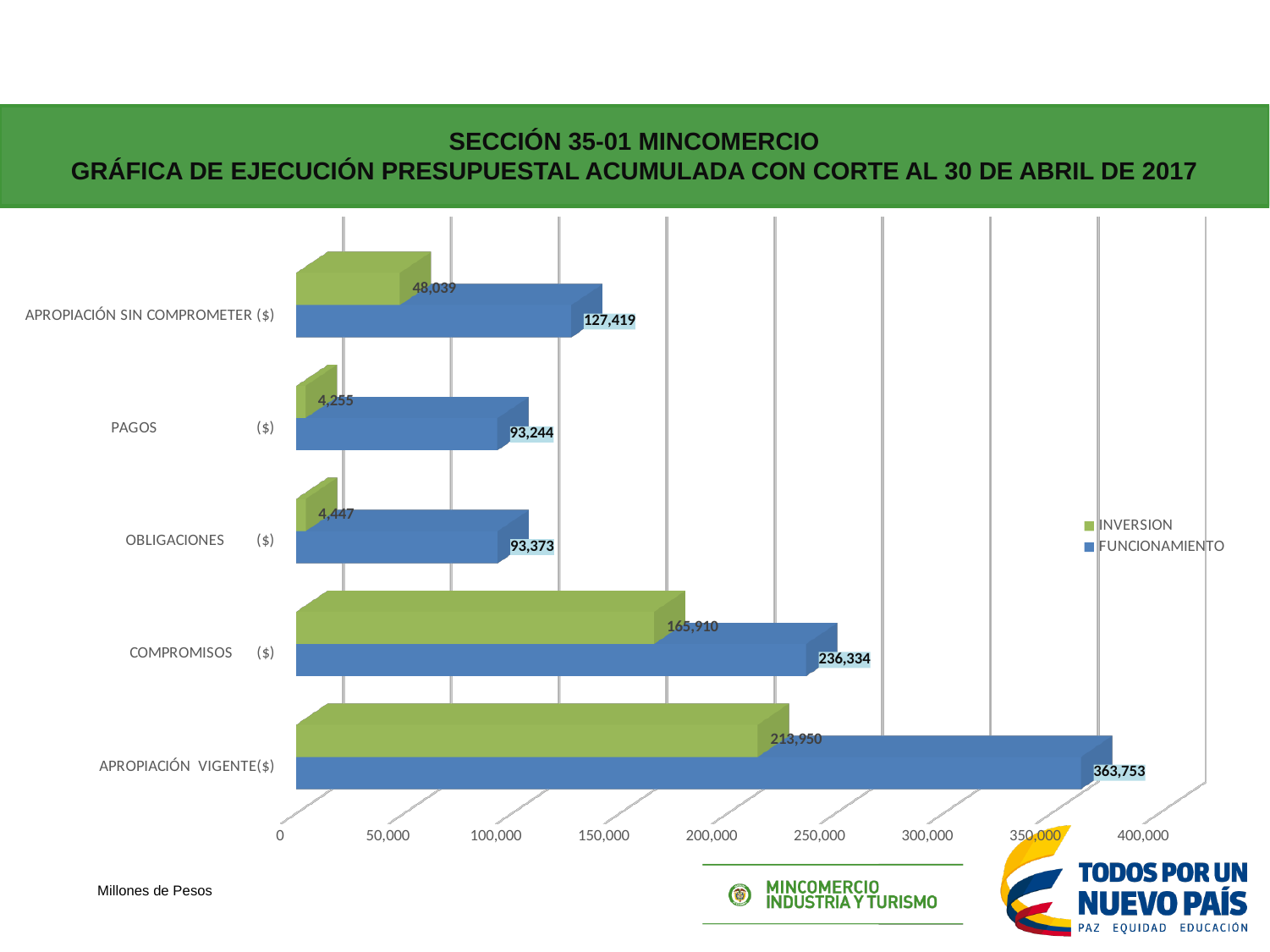
Is the FUNCIONAMIENTO value for APROPIACIÓN SIN COMPROMETER ($) greater or less than 100,000? greater What is the FUNCIONAMIENTO value for PAGOS ($)? 93,244 What is the difference between the FUNCIONAMIENTO and INVERSION values for COMPROMISOS ($)? 70,424 Which is larger for OBLIGACIONES ($): the INVERSION value or the FUNCIONAMIENTO value? FUNCIONAMIENTO What is the INVERSION value for APROPIACIÓN SIN COMPROMETER ($)? 48,039 What is the INVERSION value for COMPROMISOS ($)? 165,910 How many series does the legend list? 2 Which category has the lowest INVERSION value? PAGOS ($) Which category has the highest FUNCIONAMIENTO value? APROPIACIÓN VIGENTE($) What is the FUNCIONAMIENTO value for APROPIACIÓN VIGENTE($)? 363,753 How many categories are shown on the chart? 5 What kind of chart is shown on the slide? Bar chart